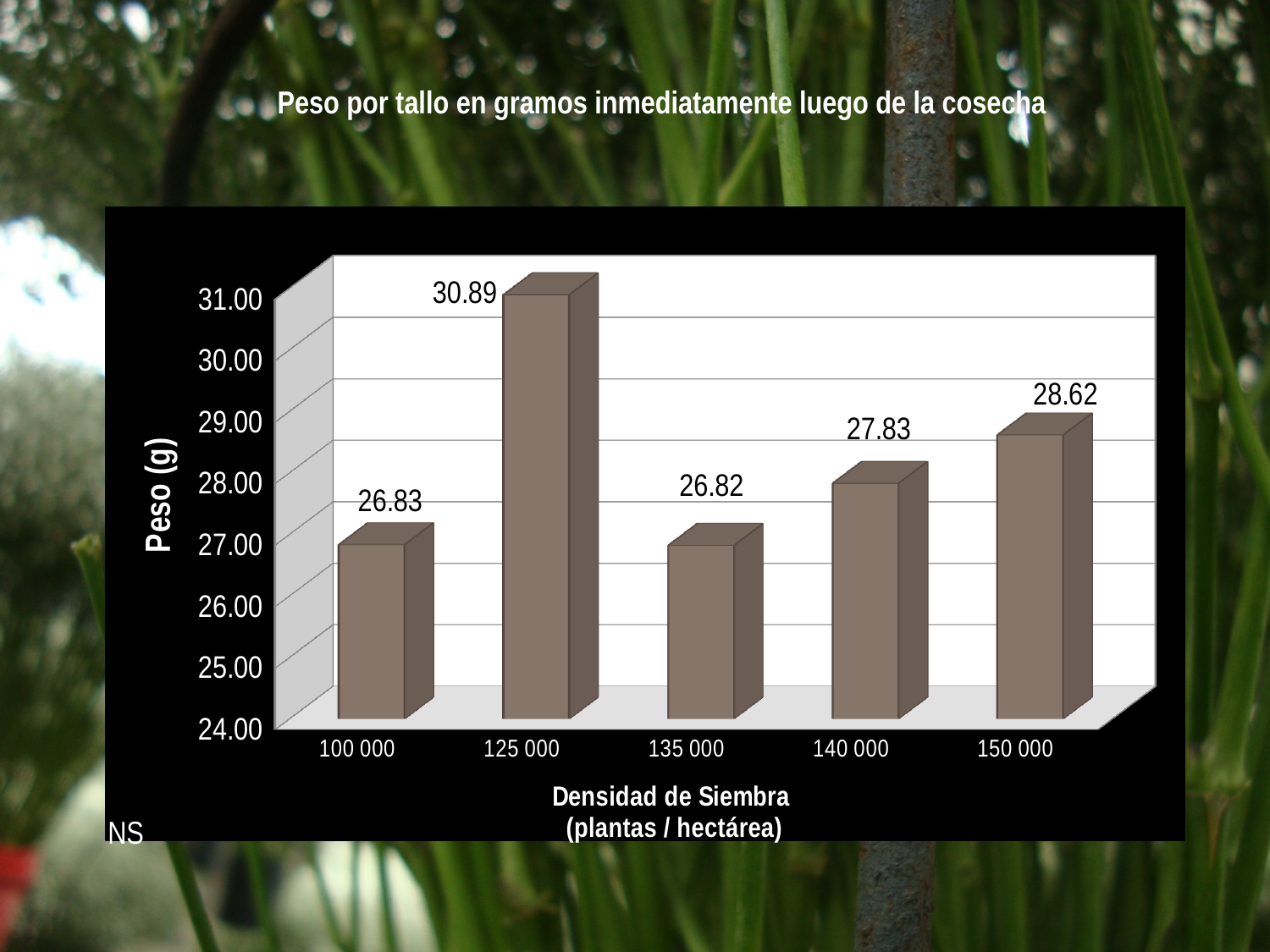
Which has a higher weight per stem, 140 000 or 150 000 plants/hectare? 150 000 What is the weight per stem for a planting density of 150 000 plants/hectare? 28.62 What is the title of the chart? Peso por tallo en gramos inmediatamente luego de la cosecha What is the weight per stem for a planting density of 140 000 plants/hectare? 27.83 Which planting density has the highest weight per stem? 125 000 What is the label of the vertical axis? Peso (g) How many planting densities are shown on the chart? 5 What is the difference in weight per stem between the 150 000 and 140 000 plants/hectare densities? 0.79 Is the weight per stem for 135 000 plants/hectare greater or less than 28.00? less What is the weight per stem for a planting density of 125 000 plants/hectare? 30.89 What is the difference in weight per stem between the 125 000 and 100 000 plants/hectare densities? 4.06 What type of chart is shown on the slide? bar chart